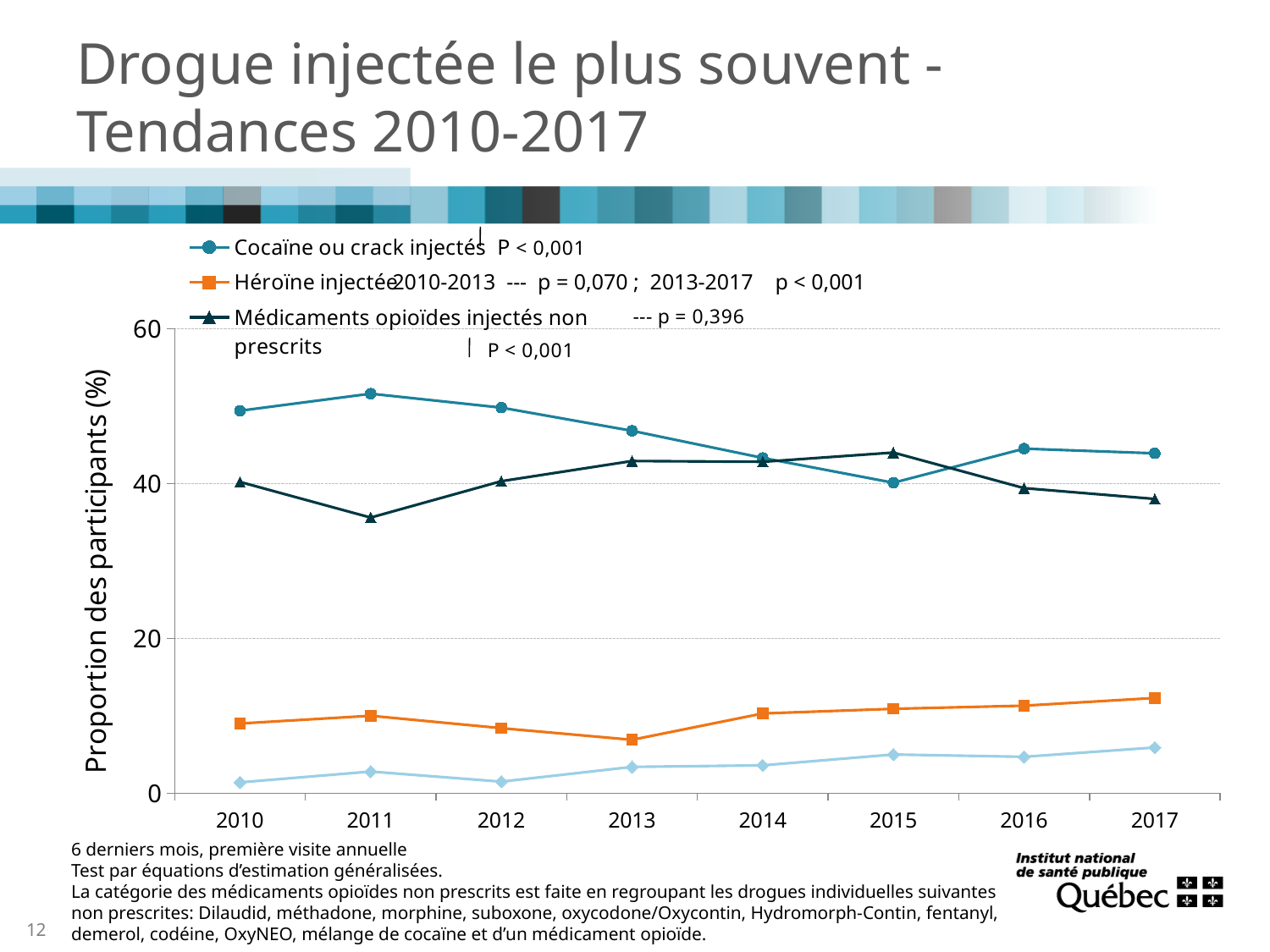
What kind of chart is shown on the slide? line chart What is the title of the y axis? Proportion des participants (%) In which year is the value for Héroïne injectée the lowest? 2013 In which year is the value for Cocaïne ou crack injectés the highest? 2011 How many series does the legend list? 3 Is the value for Cocaïne ou crack injectés in 2011 greater or less than 40? greater In which year is the value for Cocaïne ou crack injectés the lowest? 2015 Is the value for Héroïne injectée in 2017 greater or less than 20? less Does the value for Héroïne injectée rise or fall from 2013 to 2017? rise In which year is the value for Médicaments opioïdes injectés non prescrits the lowest? 2011 How many years are plotted along the x axis? 8 In 2010, which is larger: Cocaïne ou crack injectés or Médicaments opioïdes injectés non prescrits? Cocaïne ou crack injectés